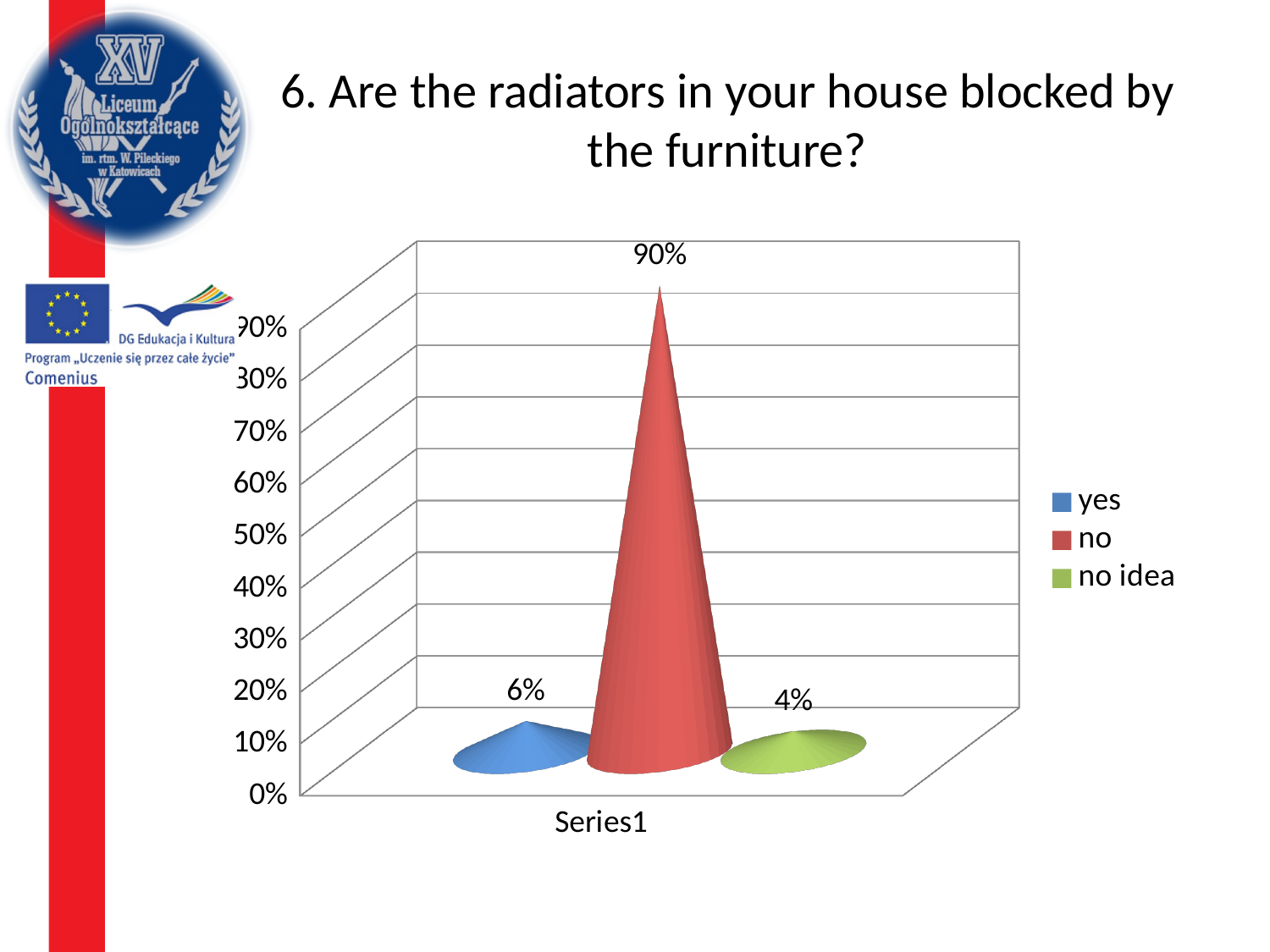
What is the difference in percentage points between the "no" and "yes" answers? 84 What percentage of respondents answered "no idea"? 4% What is the difference in percentage points between the "yes" and "no idea" answers? 2 What percentage of respondents answered "yes"? 6% Is the value for "no" greater or less than 80%? greater Which is larger, the value for "yes" or the value for "no idea"? yes What kind of chart is shown on the slide? bar chart What colour represents the "no" answer in the chart? red Which answer has the lowest percentage? no idea What percentage of respondents answered "no" to whether the radiators in their house are blocked by furniture? 90% How many series does the legend list? 3 Which answer has the highest percentage? no